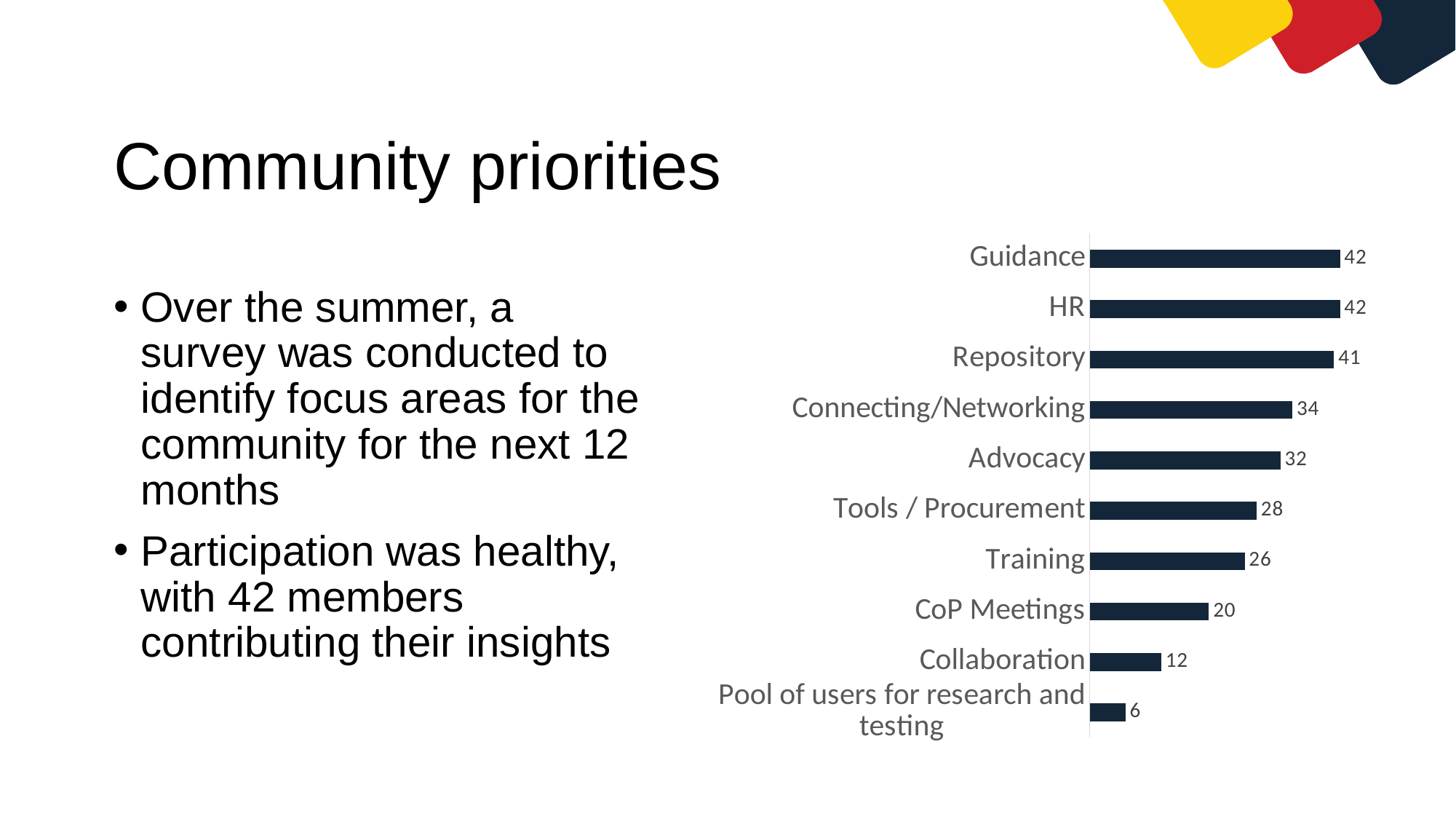
Which is larger, the value for Tools / Procurement or the value for CoP Meetings? Tools / Procurement What is the value for Training? 26 What colour are the bars in the chart? Dark navy blue What is the value for Pool of users for research and testing? 6 What is the difference between the values for Advocacy and Training? 6 What is the value for Connecting/Networking? 34 What is the value for Guidance? 42 Which category has the lowest value? Pool of users for research and testing What is the difference between the values for Repository and Collaboration? 29 What is the value for CoP Meetings? 20 What kind of chart is shown on the slide? Bar chart How many categories are shown in the chart? 10